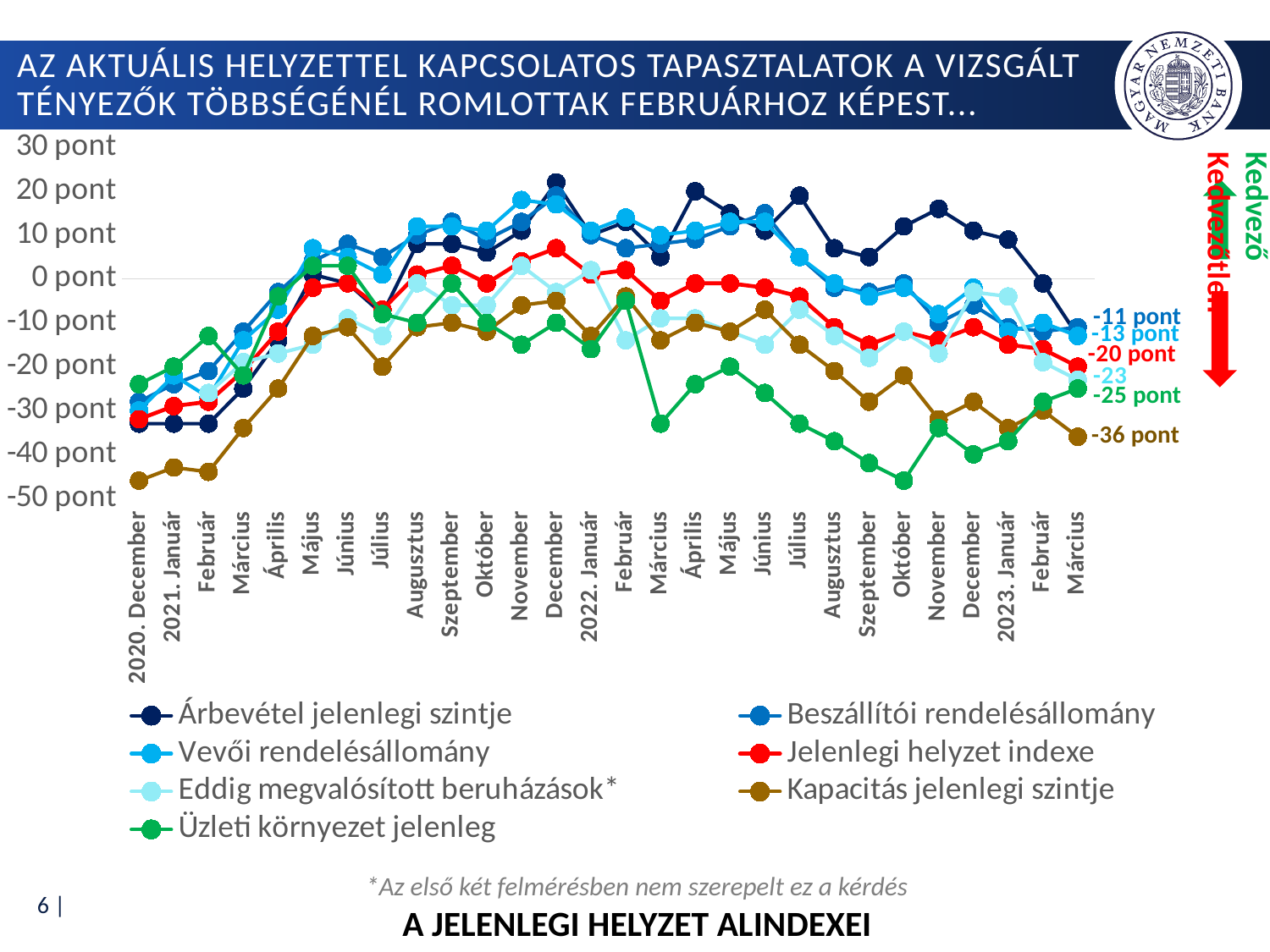
What is the value of Jelenlegi helyzet indexe in 2023. Március, as labelled at the end of the line? -20 pont Which series has the lowest value in 2023. Március? Kapacitás jelenlegi szintje In 2023. Március, which is larger: Jelenlegi helyzet indexe or Üzleti környezet jelenleg? Jelenlegi helyzet indexe Which series has the highest value in 2023. Március? Beszállítói rendelésállomány How many series does the legend list? 7 What is the value of Árbevétel jelenlegi szintje in 2023. Március, as labelled at the end of the line? -13 pont What is the chart's title shown at the bottom of the slide? A jelenlegi helyzet alindexei What kind of chart is shown on the slide? line chart What is the value of Kapacitás jelenlegi szintje in 2023. Március, as labelled at the end of the line? -36 pont How many months are shown on the x axis, from 2020. December to 2023. Március? 28